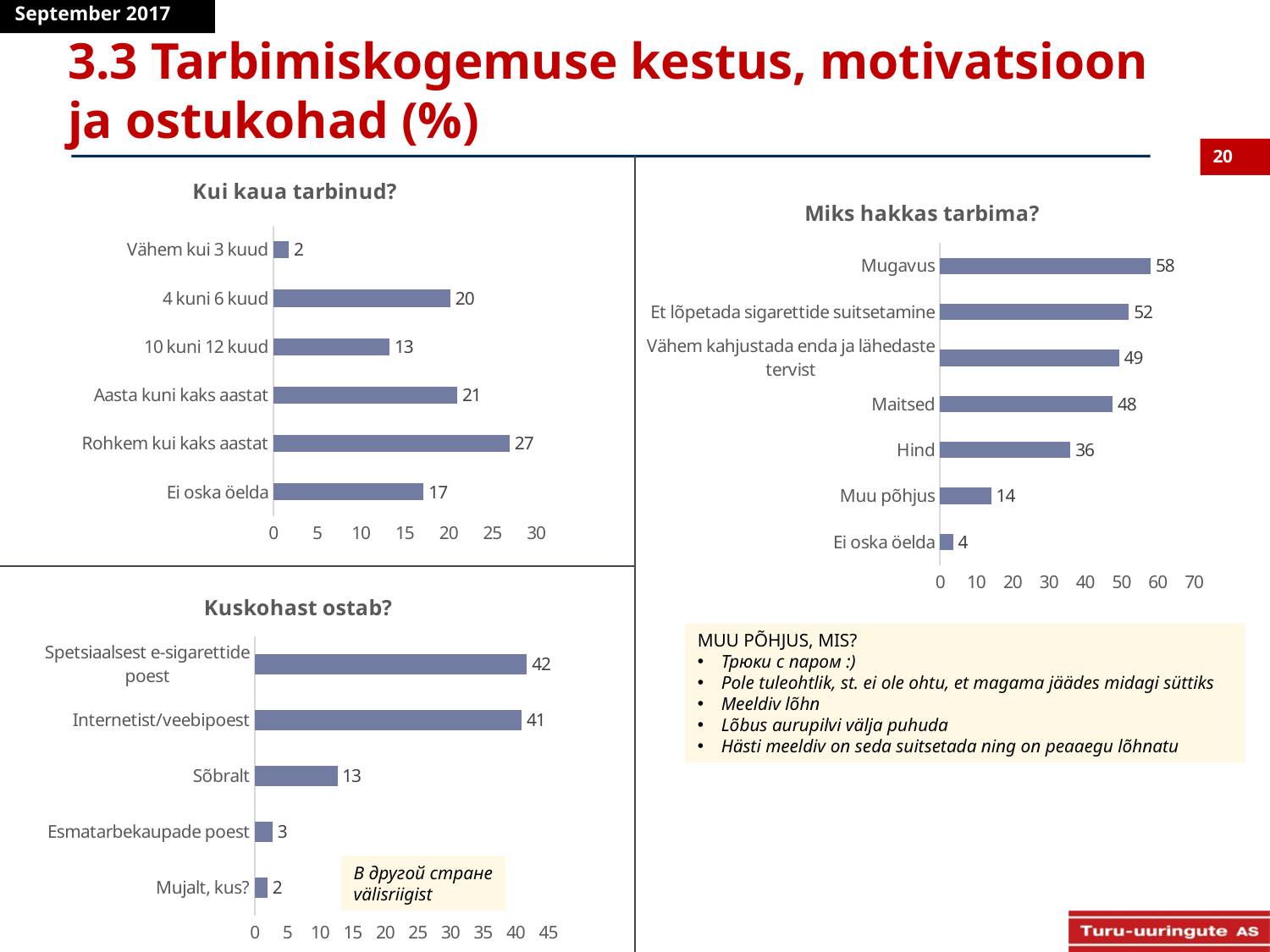
What type of chart is 'Kuskohast ostab?'? Bar chart In the 'Miks hakkas tarbima?' chart, what is the difference between 'Mugavus' and 'Et lõpetada sigarettide suitsetamine'? 6 In the 'Kuskohast ostab?' chart, what is the difference between 'Sõbralt' and 'Esmatarbekaupade poest'? 10 In the 'Kuskohast ostab?' chart, how many categories are shown? 5 In the 'Miks hakkas tarbima?' chart, which is larger: 'Maitsed' or 'Muu põhjus'? Maitsed In the 'Miks hakkas tarbima?' chart, which category has the highest value? Mugavus In the 'Kui kaua tarbinud?' chart, what is the value for 'Rohkem kui kaks aastat'? 27 In the 'Kuskohast ostab?' chart, what is the value for 'Internetist/veebipoest'? 41 In the 'Kui kaua tarbinud?' chart, which category has the lowest value? Vähem kui 3 kuud In the 'Kui kaua tarbinud?' chart, how many categories are shown? 6 In the 'Miks hakkas tarbima?' chart, what is the value for 'Hind'? 36 In the 'Kui kaua tarbinud?' chart, what is the difference between '4 kuni 6 kuud' and '10 kuni 12 kuud'? 7